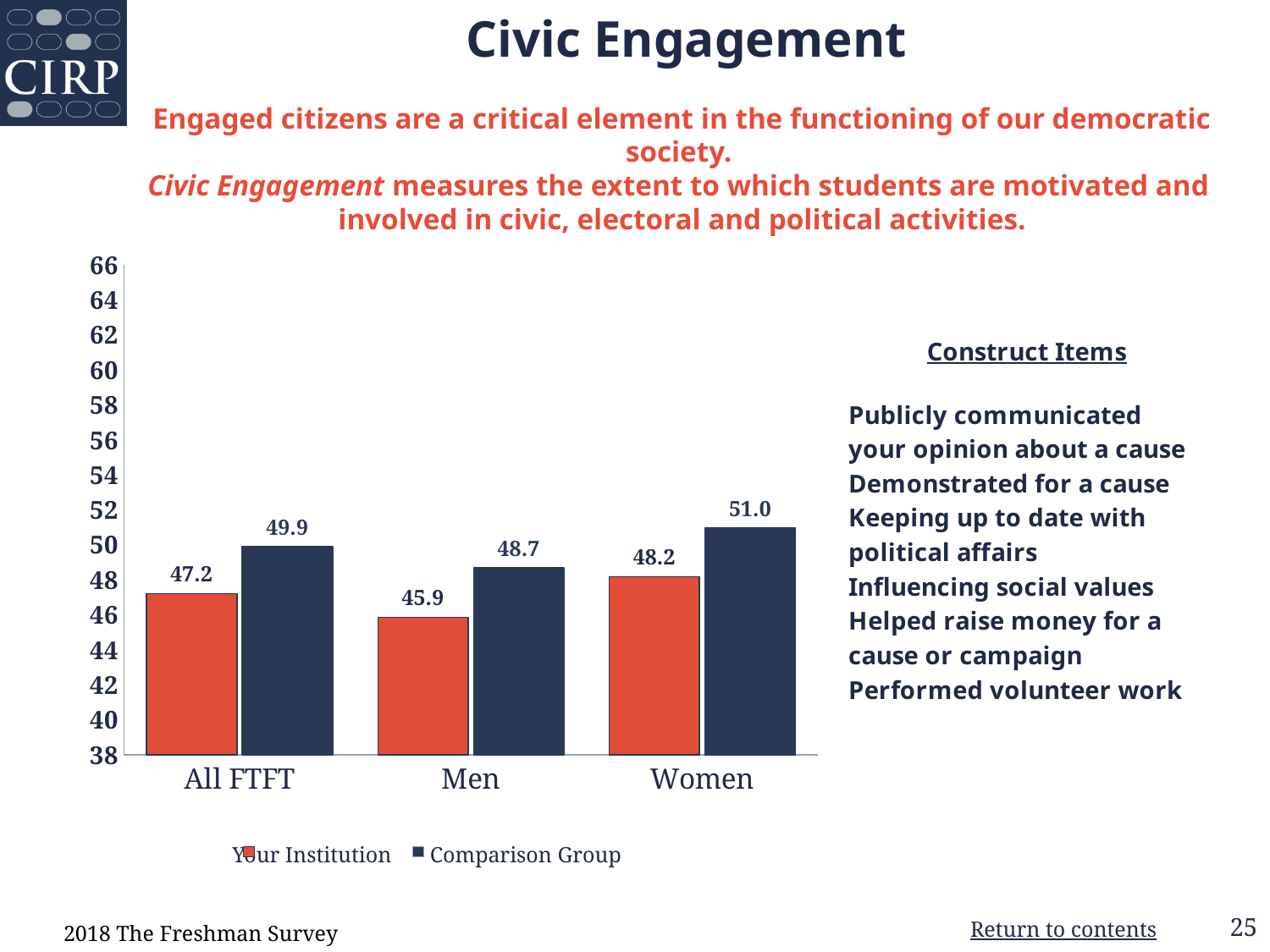
What is the difference between the Comparison Group and Your Institution values for Women? 2.8 How many series does the legend list? 2 What is the value for Your Institution in the All FTFT category? 47.2 Which category has the highest Comparison Group value? Women Which category has the lowest Your Institution value? Men What is the value for the Comparison Group in the Women category? 51.0 What is the difference between the Comparison Group and Your Institution values for All FTFT? 2.7 What is the value for the Comparison Group in the Men category? 48.7 What kind of chart is shown on the slide? Bar chart How many categories are shown on the x axis? 3 Which is larger for Men: Your Institution or the Comparison Group? Comparison Group What is the value for Your Institution in the Men category? 45.9